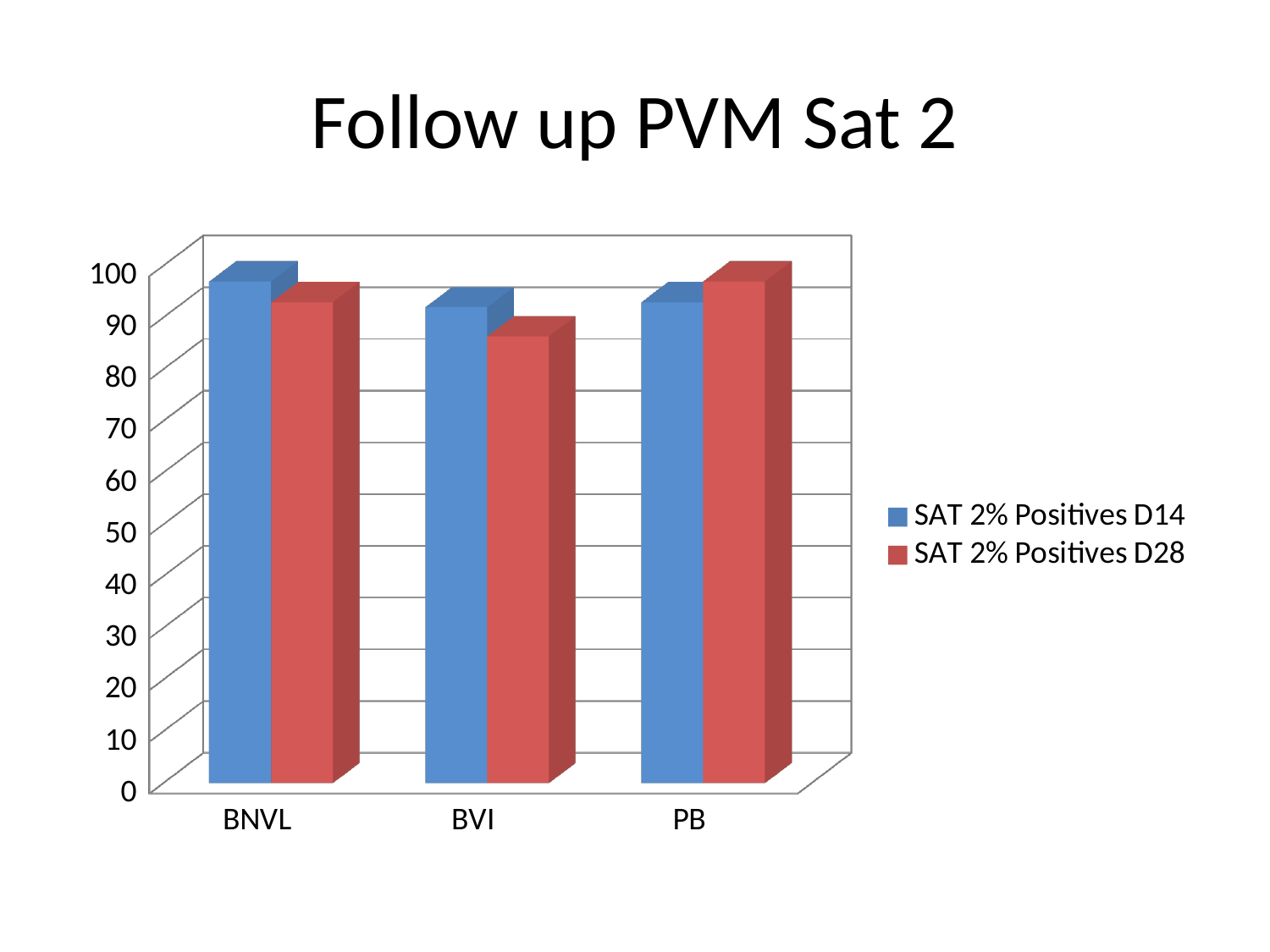
Which category has the highest value for SAT 2% Positives D14? BNVL How many series does the legend list? 2 What is the title of the chart? Follow up PVM Sat 2 What kind of chart is shown on the slide? bar chart For PB, which is larger: SAT 2% Positives D14 or SAT 2% Positives D28? SAT 2% Positives D28 For BVI, which is larger: SAT 2% Positives D14 or SAT 2% Positives D28? SAT 2% Positives D14 How many categories are shown on the x axis? 3 Is the SAT 2% Positives D14 value for BNVL greater or less than 90? greater Which category has the highest value for SAT 2% Positives D28? PB Which colour represents the SAT 2% Positives D28 series? red Which category has the lowest value for SAT 2% Positives D28? BVI Is the SAT 2% Positives D28 value for BVI greater or less than 90? less